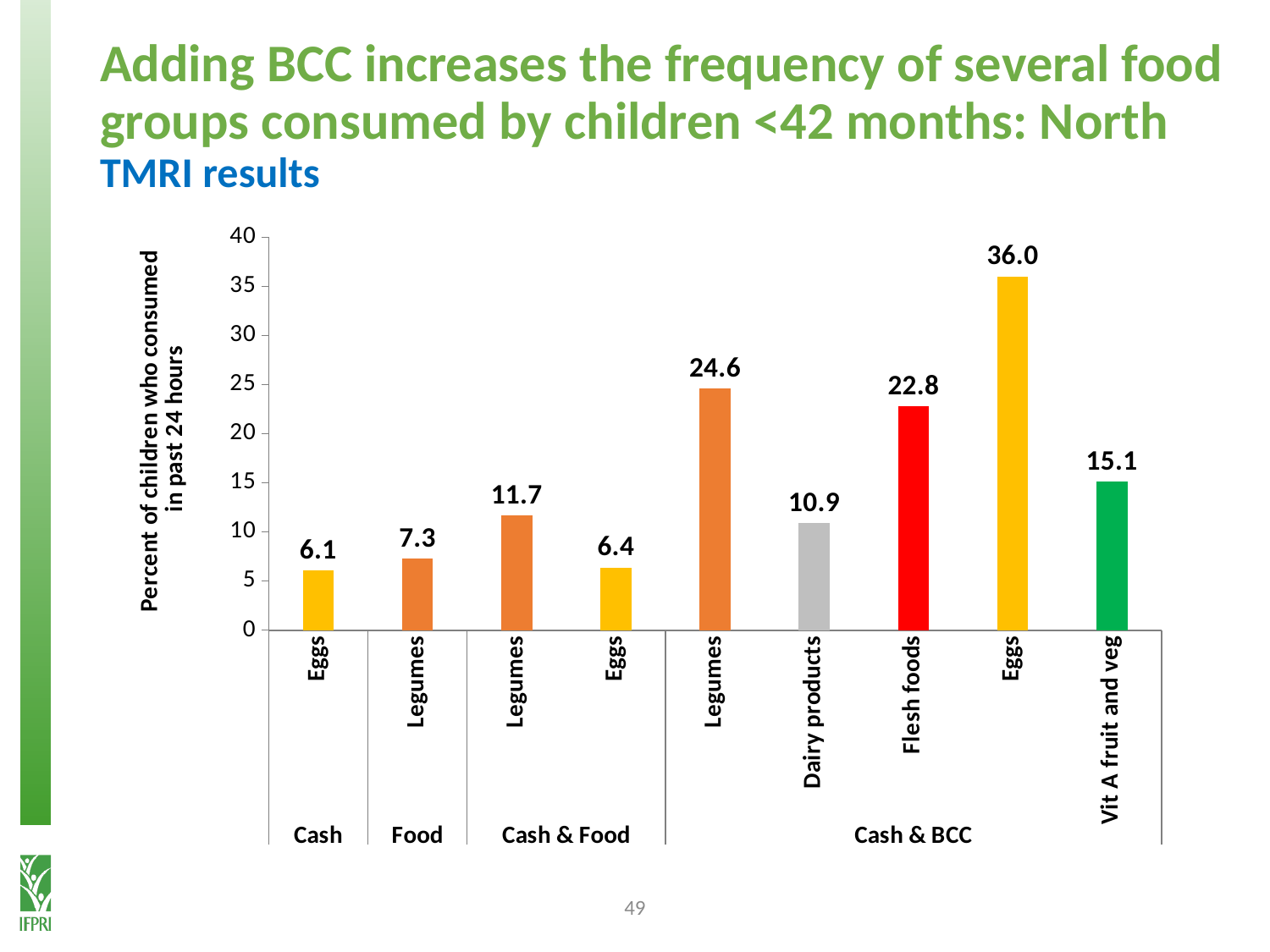
What is the label of the vertical axis? Percent of children who consumed in past 24 hours What is the value for Eggs in the Cash & BCC group? 36.0 How many bars are plotted on the chart? 9 Which bar has the highest value on the chart? Eggs (Cash & BCC) What is the value for Dairy products in the Cash & BCC group? 10.9 What is the value for Legumes in the Cash & Food group? 11.7 Is the value for Vit A fruit and veg greater or less than 20? less What is the difference between Eggs in the Cash & BCC group and Eggs in the Cash & Food group? 29.6 Which bar has the lowest value on the chart? Eggs (Cash) What kind of chart is shown on the slide? bar chart What is the value for Eggs in the Cash group? 6.1 Which is larger: Legumes in the Cash & BCC group or Flesh foods in the Cash & BCC group? Legumes